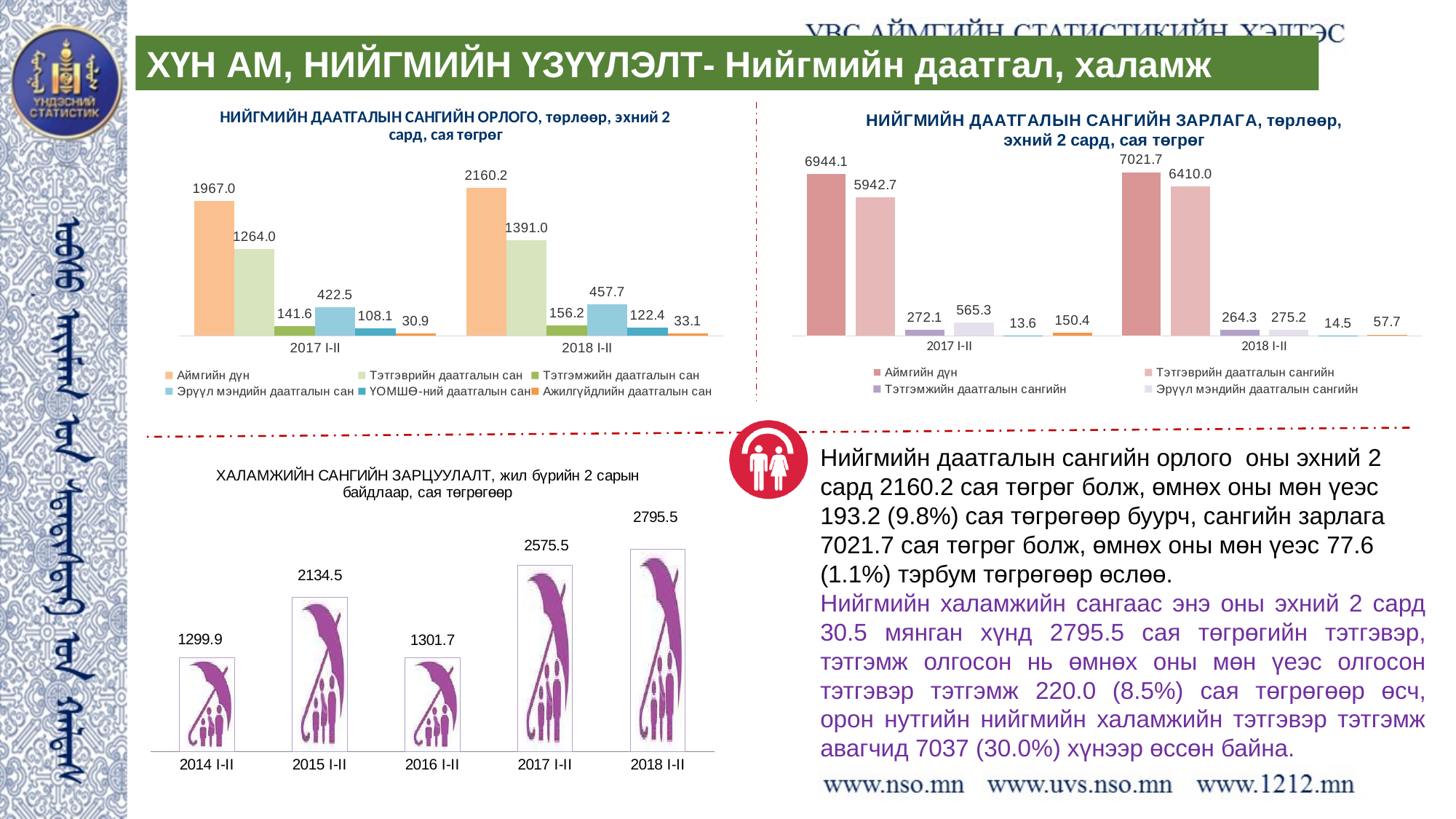
In the chart titled 'НИЙГМИЙН ДААТГАЛЫН САНГИЙН ОРЛОГО', what is the value of Эрүүл мэндийн даатгалын сан for 2017 I-II? 422.5 In the chart titled 'НИЙГМИЙН ДААТГАЛЫН САНГИЙН ОРЛОГО', how many series does the legend list? 6 In the chart titled 'ХАЛАМЖИЙН САНГИЙН ЗАРЦУУЛАЛТ', which year has the highest value? 2018 I-II In the chart titled 'НИЙГМИЙН ДААТГАЛЫН САНГИЙН ЗАРЛАГА', how many series does the legend list? 4 In the chart titled 'ХАЛАМЖИЙН САНГИЙН ЗАРЦУУЛАЛТ', what is the value for 2016 I-II? 1301.7 In the chart titled 'ХАЛАМЖИЙН САНГИЙН ЗАРЦУУЛАЛТ', how many years are shown on the x axis? 5 In the chart titled 'НИЙГМИЙН ДААТГАЛЫН САНГИЙН ЗАРЛАГА', what is the value of Тэтгэврийн даатгалын сангийн for 2018 I-II? 6410.0 In the chart titled 'НИЙГМИЙН ДААТГАЛЫН САНГИЙН ОРЛОГО', by how much did Тэтгэврийн даатгалын сан change from 2017 I-II to 2018 I-II? 127.0 In the chart titled 'НИЙГМИЙН ДААТГАЛЫН САНГИЙН ОРЛОГО', which series has the lowest value in 2018 I-II? Ажилгүйдлийн даатгалын сан In the chart titled 'НИЙГМИЙН ДААТГАЛЫН САНГИЙН ЗАРЛАГА', what is the value of Аймгийн дүн for 2017 I-II? 6944.1 In the chart titled 'НИЙГМИЙН ДААТГАЛЫН САНГИЙН ЗАРЛАГА', is the Аймгийн дүн value larger in 2017 I-II or 2018 I-II? 2018 I-II In the chart titled 'НИЙГМИЙН ДААТГАЛЫН САНГИЙН ОРЛОГО', what is the value of Аймгийн дүн for 2018 I-II? 2160.2